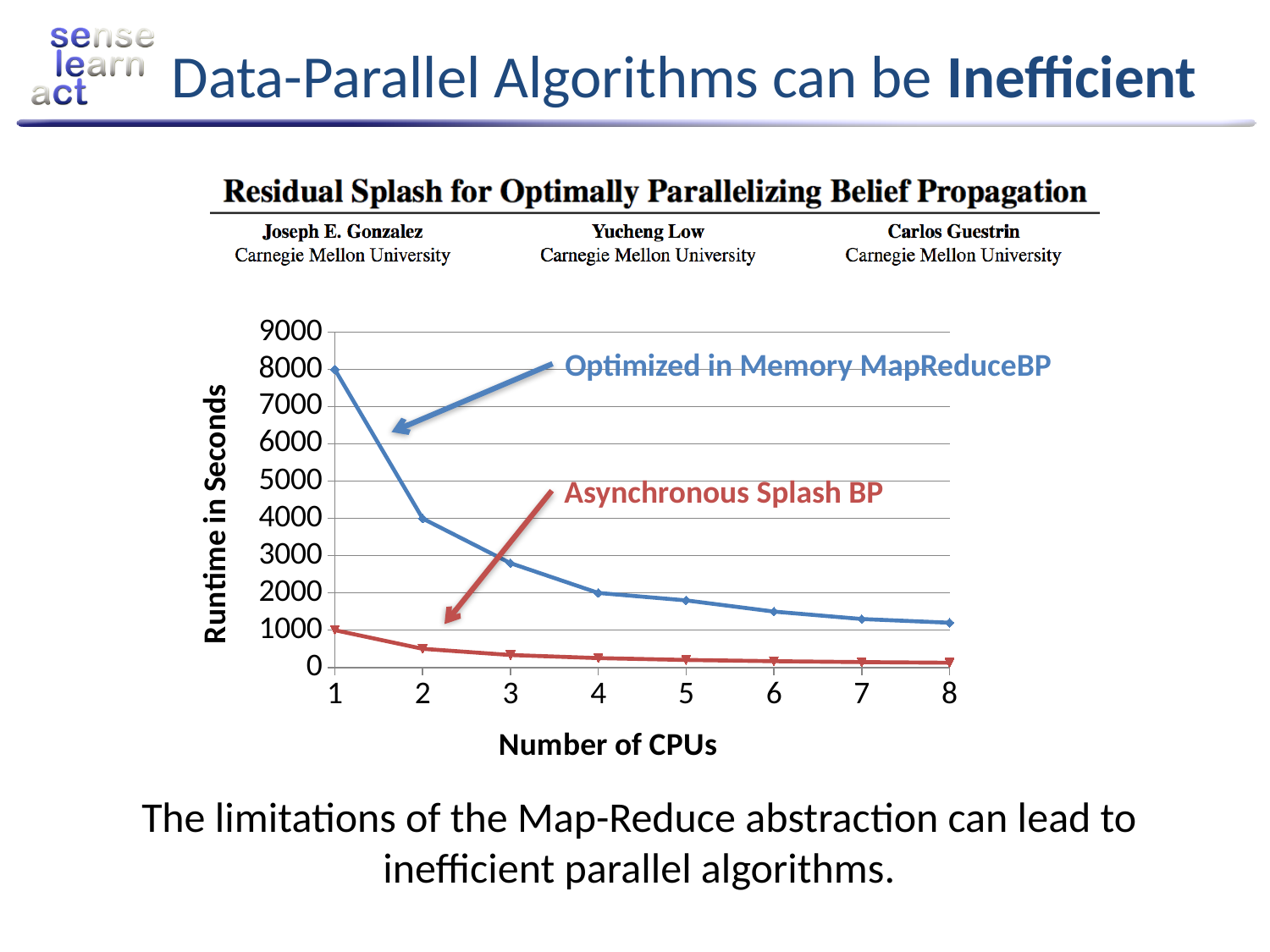
What kind of chart is shown on the slide? line chart Is the runtime of Optimized in Memory MapReduceBP at 3 CPUs greater or less than 2000? greater Which series is drawn in red? Asynchronous Splash BP What is the label of the y axis? Runtime in Seconds How many series are plotted on the chart? 2 How many points along the x axis (Number of CPUs) does each line have? 8 Does the runtime of Optimized in Memory MapReduceBP rise or fall as the number of CPUs increases? fall Is the runtime of Asynchronous Splash BP at 8 CPUs greater or less than 1000? less What is the runtime of Optimized in Memory MapReduceBP at 1 CPU? 8000 Which series has the higher runtime at 4 CPUs, Optimized in Memory MapReduceBP or Asynchronous Splash BP? Optimized in Memory MapReduceBP What is the runtime of Asynchronous Splash BP at 1 CPU? 1000